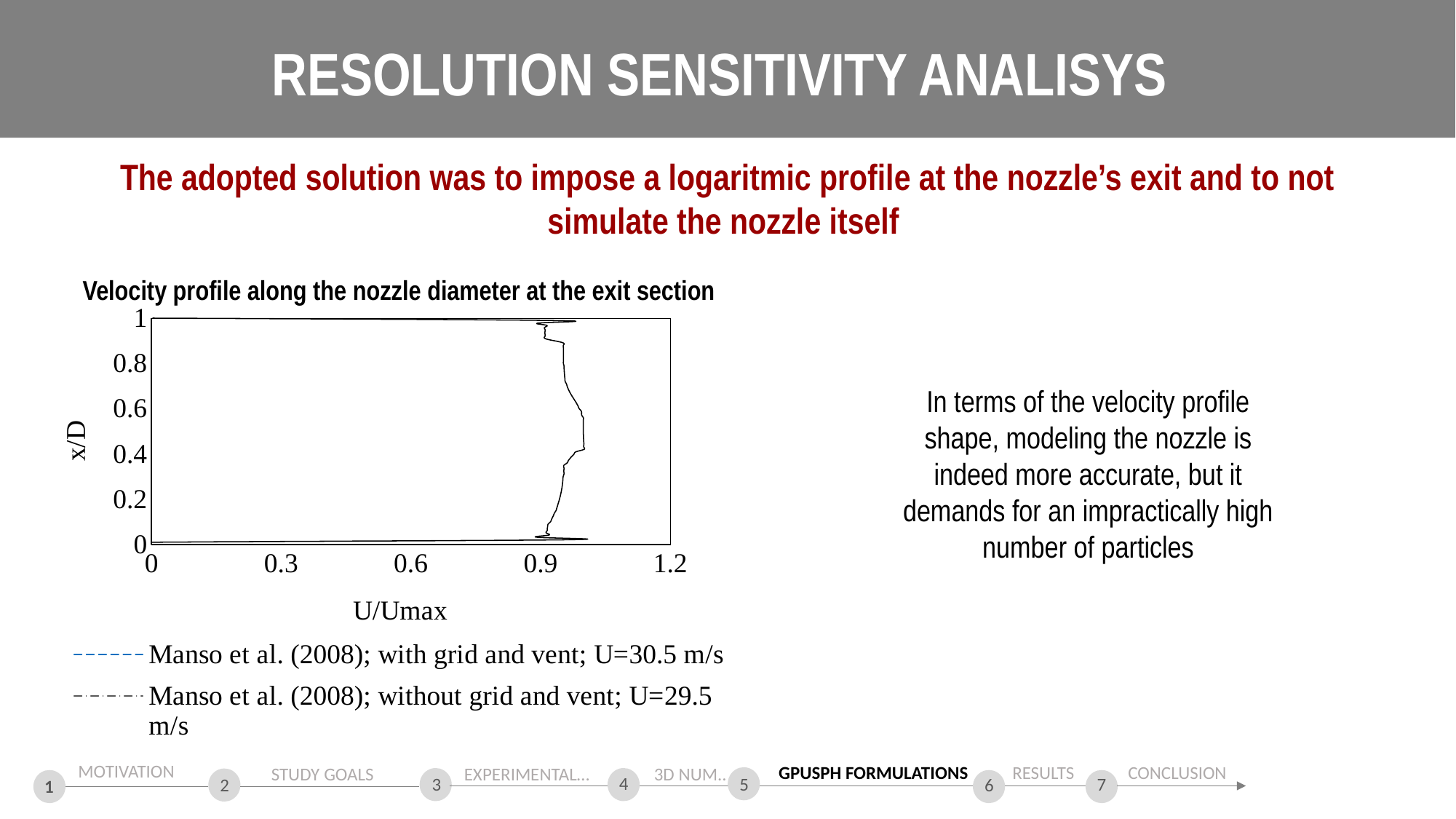
How many series does the chart's legend list? 2 Which velocity U is given in the legend entry for 'with grid and vent'? U=30.5 m/s What is the title of the chart? Velocity profile along the nozzle diameter at the exit section What is the label of the y axis of the chart? x/D What kind of chart is shown on the slide? line chart At x/D = 0.2, is the plotted U/Umax value greater or less than 0.6? greater At x/D = 0.5, is the plotted U/Umax value greater or less than 1.2? less At x/D = 0.5, is the plotted U/Umax value greater or less than 0.9? greater Which velocity U is given in the legend entry for 'without grid and vent'? U=29.5 m/s What is the label of the x axis of the chart? U/Umax